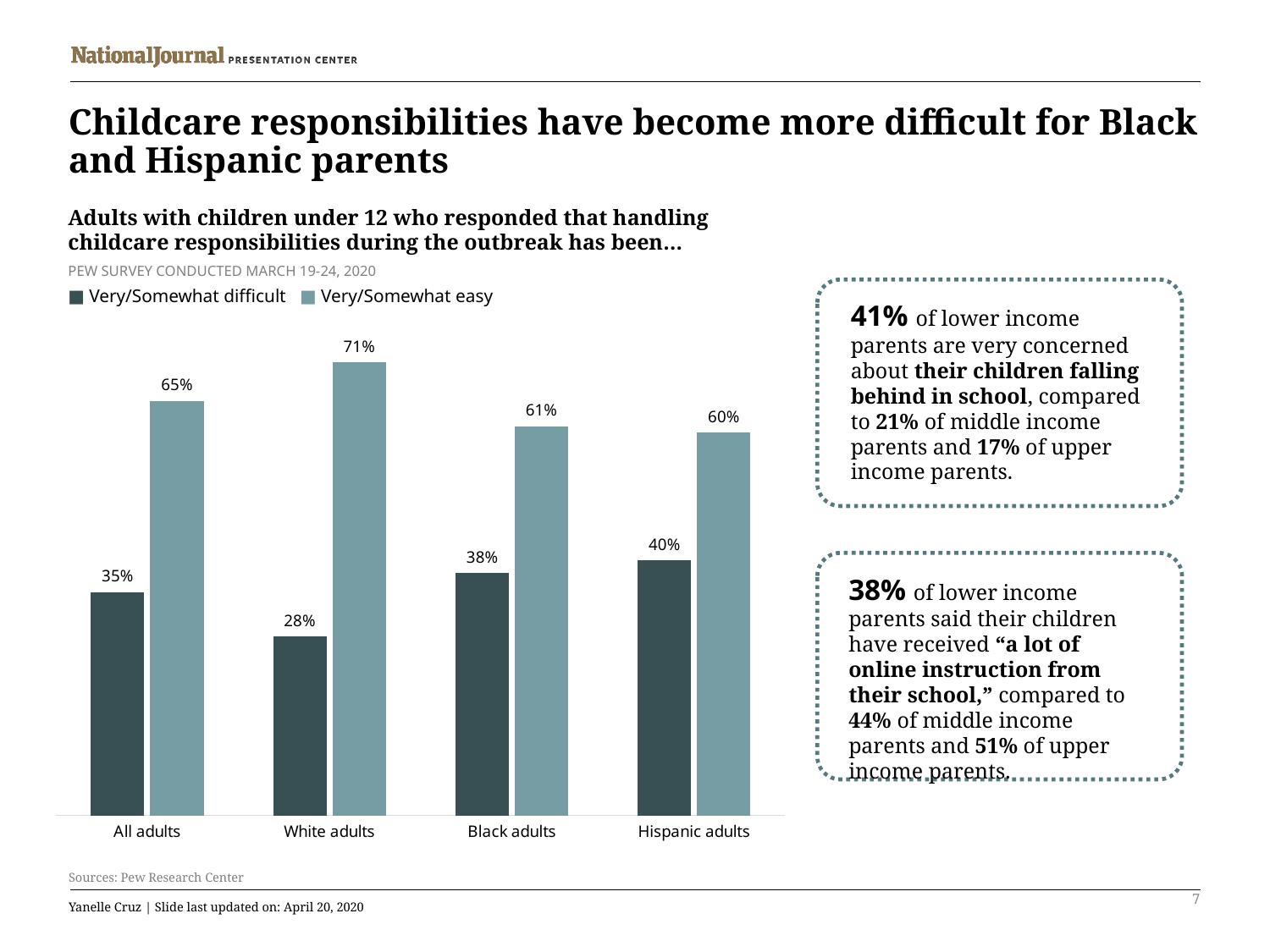
What percentage of Hispanic adults said handling childcare responsibilities has been very/somewhat easy? 60% Which group has the lowest value for Very/Somewhat difficult? White adults How many series does the legend list? 2 How many groups of adults are shown on the x axis? 4 What is the difference between the Very/Somewhat easy and Very/Somewhat difficult values for All adults? 30 percentage points What is the difference between the Very/Somewhat easy values for White adults and Hispanic adults? 11 percentage points Which is larger: the Very/Somewhat difficult value for Hispanic adults or for Black adults? Hispanic adults Which legend entry is shown in the darker colour? Very/Somewhat difficult What is the value for Black adults in the Very/Somewhat difficult series? 38% What percentage of White adults said handling childcare responsibilities has been very/somewhat difficult? 28% Which group has the highest value for Very/Somewhat easy? White adults What kind of chart is shown on the slide? Bar chart